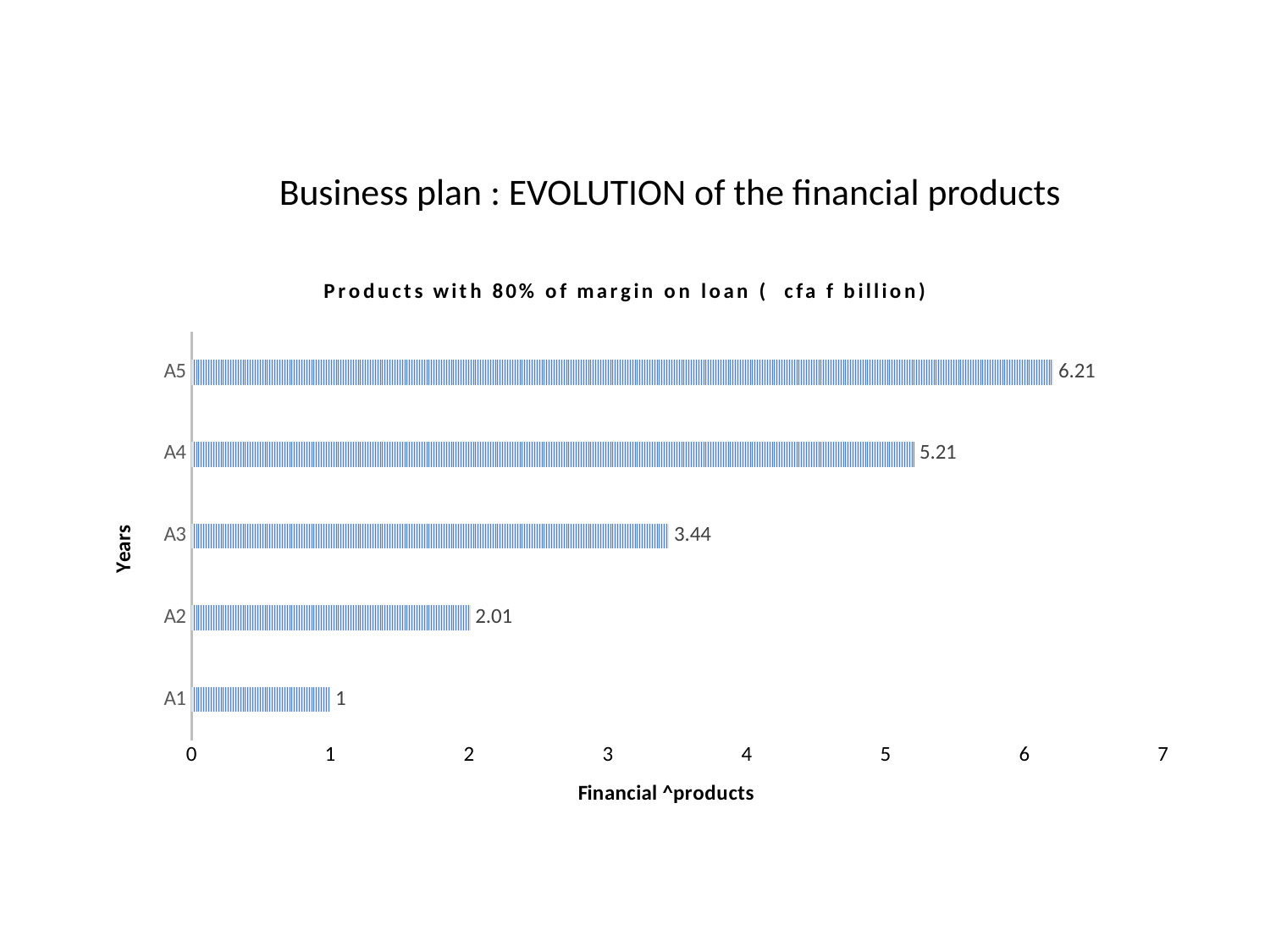
What is the value for A5? 6.21 How many years are shown on the chart? 5 Which is larger, the value for A4 or the value for A3? A4 What kind of chart is shown? bar chart Which year has the lowest value? A1 What is the label of the horizontal axis? Financial ^products What is the difference between the values for A3 and A2? 1.43 What is the value for A3? 3.44 What is the difference between the values for A5 and A4? 1 Do the values rise or fall from A1 to A5? rise What is the value for A1? 1 Which year has the highest value? A5